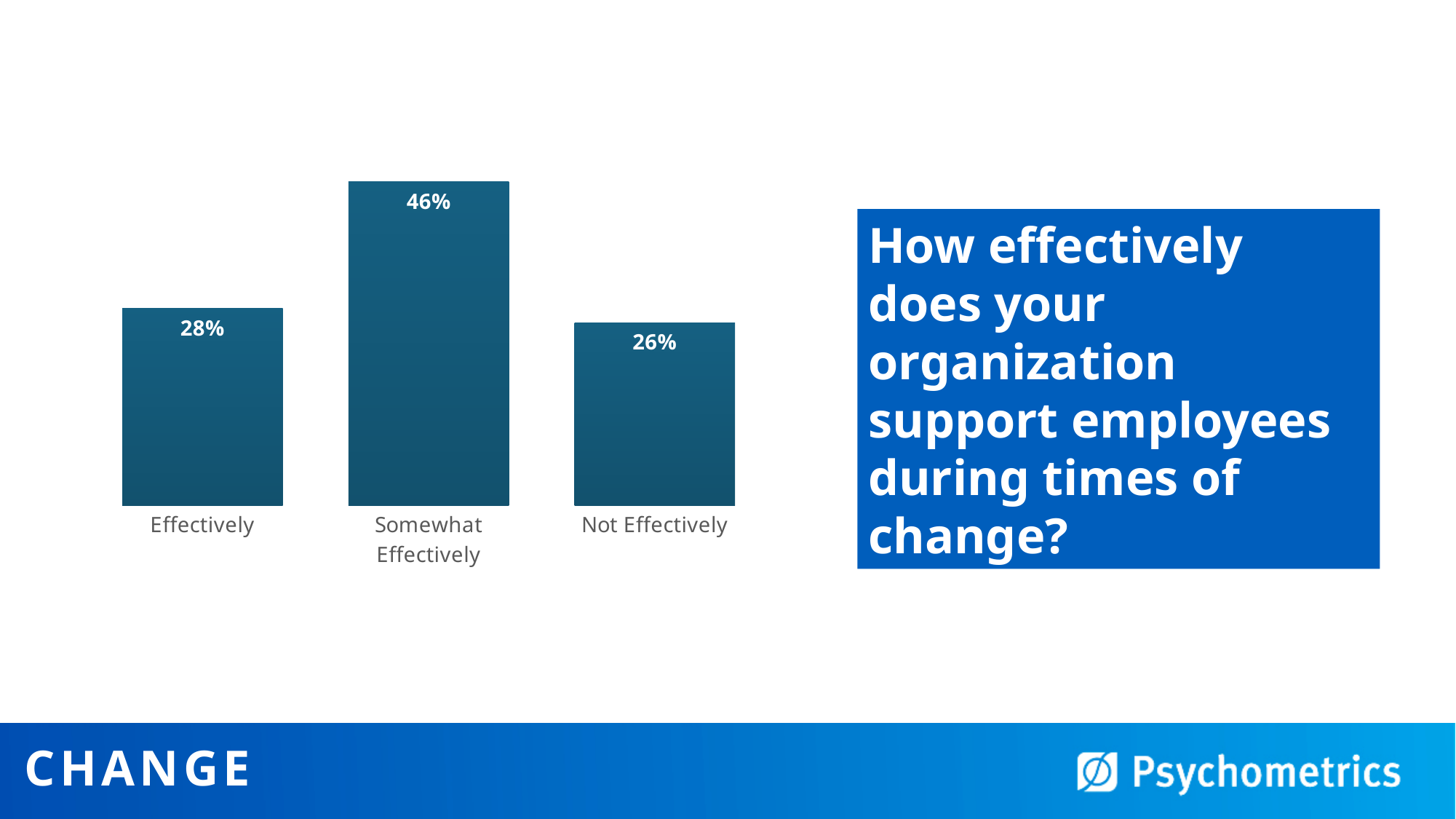
What percentage of respondents said their organization supports employees "Effectively" during times of change? 28% What is the value shown for "Not Effectively"? 26% What is the value shown for "Somewhat Effectively"? 46% What kind of chart is shown on the slide? Bar chart Which category has the highest value? Somewhat Effectively What is the difference between the values for "Somewhat Effectively" and "Effectively"? 18% Which category has the lowest value? Not Effectively What is the total of the three percentages shown in the chart? 100% What is the difference between the values for "Effectively" and "Not Effectively"? 2% How many categories are shown in the chart? 3 What question does the chart on the slide answer, according to the blue text box? How effectively does your organization support employees during times of change? Which is larger, the value for "Somewhat Effectively" or the value for "Not Effectively"? Somewhat Effectively